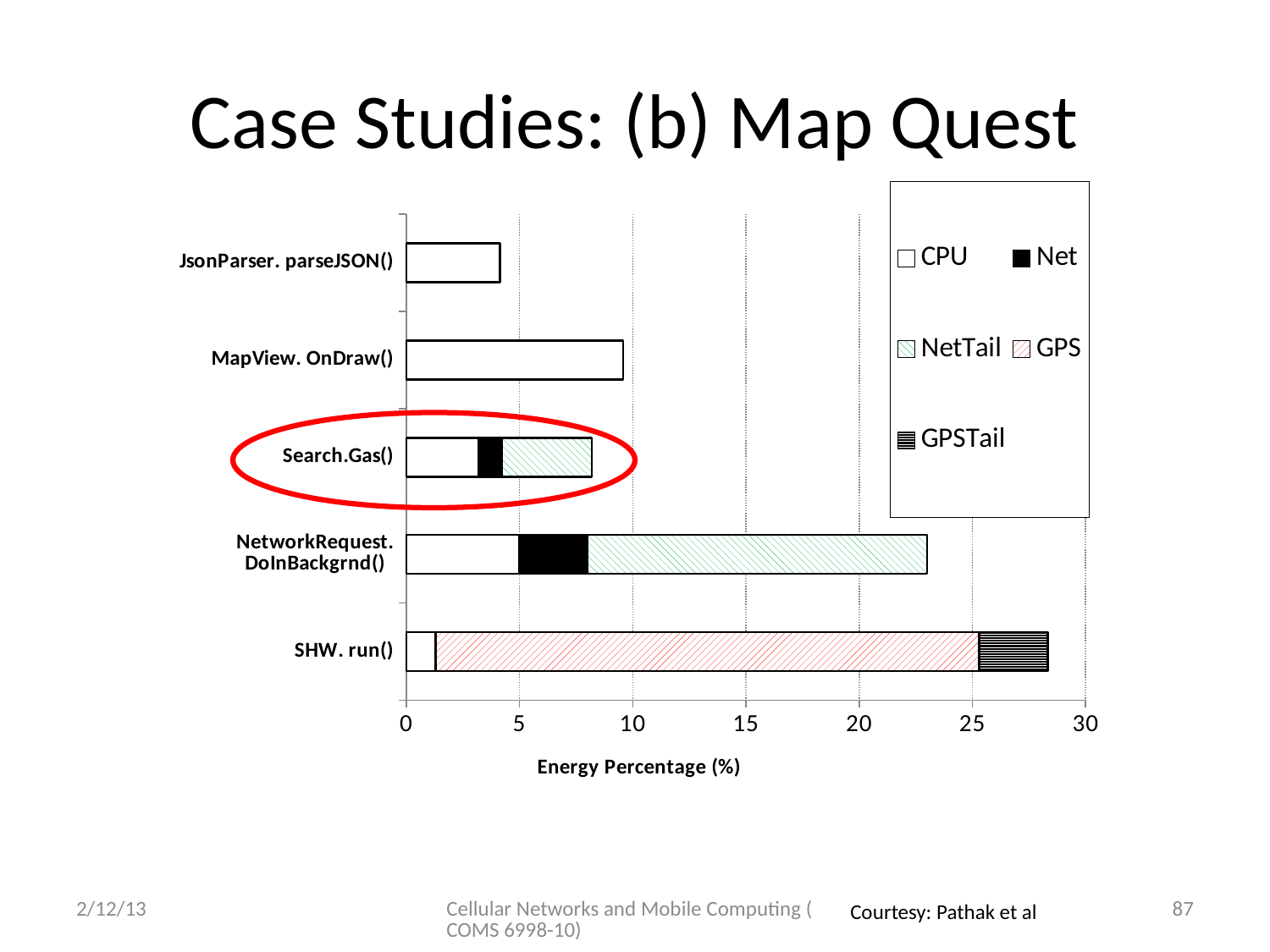
Which category has the longest total bar? SHW. run() Is the total value for SHW. run() greater or less than 25? greater Which category is highlighted with a red circle on the chart? Search.Gas() How many series does the legend list? 5 Which category has the shortest total bar? JsonParser. parseJSON() What is the title of the x axis? Energy Percentage (%) How many categories (methods) are plotted on the chart? 5 Is the total value for Search.Gas() greater or less than 10? less Which has the larger total bar, NetworkRequest. DoInBackgrnd() or MapView. OnDraw()? NetworkRequest. DoInBackgrnd() Is the total value for NetworkRequest. DoInBackgrnd() greater or less than 20? greater What kind of chart is shown on the slide? bar chart